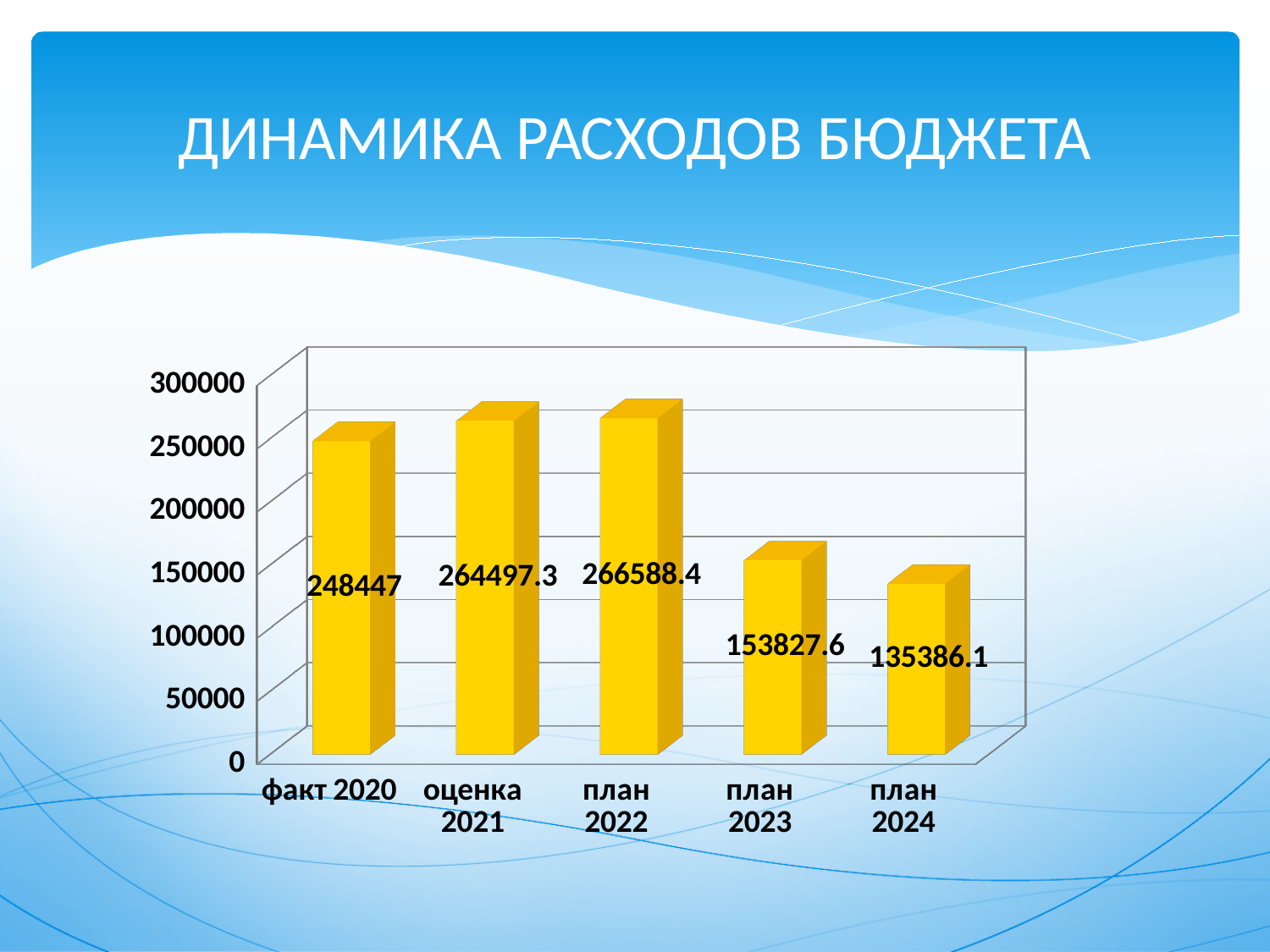
What is the value for оценка 2021? 264497.3 Is the value for план 2024 greater or less than 150000? less What is the difference between the values for план 2023 and план 2024? 18441.5 Which is larger, the value for факт 2020 or the value for план 2023? факт 2020 What is the difference between the values for план 2022 and оценка 2021? 2091.1 Which category has the highest value? план 2022 What is the title of the chart on the slide? ДИНАМИКА РАСХОДОВ БЮДЖЕТА How many categories are shown on the x axis? 5 What kind of chart is shown on the slide? bar chart Which category has the lowest value? план 2024 What is the value for план 2023? 153827.6 What is the value for факт 2020? 248447